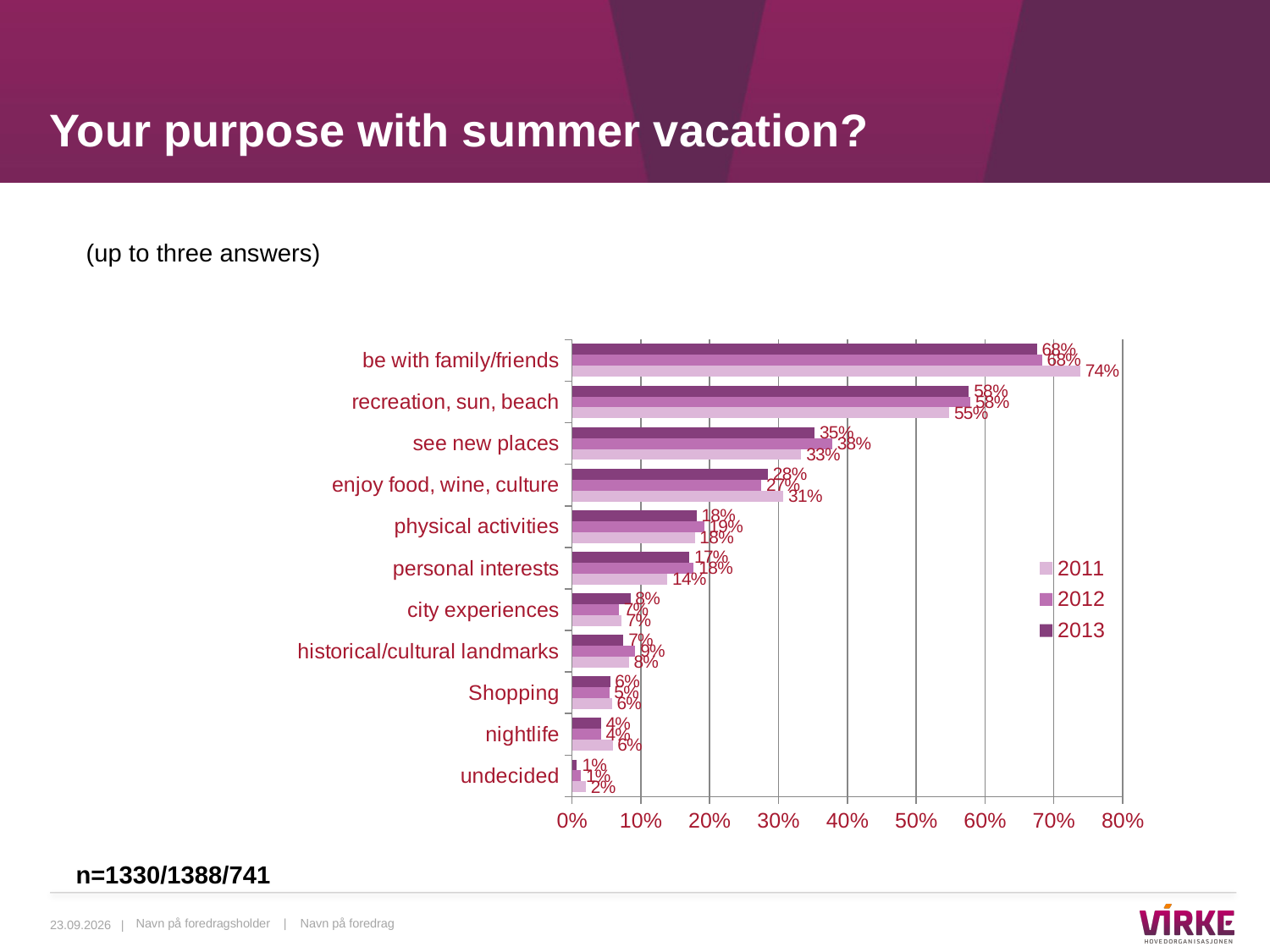
Which category has the highest value across all series? be with family/friends What is the 2011 value for 'recreation, sun, beach'? 55% What is the 2011 value for 'see new places'? 33% What is the 2011 value for 'be with family/friends'? 74% What is the 2011 value for 'personal interests'? 14% How many series does the legend list? 3 Is the 2011 value for 'see new places' greater or less than 40%? less What type of chart is shown on the slide? bar chart Which category has the lowest values? undecided What is the difference between the 2011 values for 'be with family/friends' and 'recreation, sun, beach'? 19% What is the 2011 value for 'enjoy food, wine, culture'? 31% How many categories are shown on the chart? 11